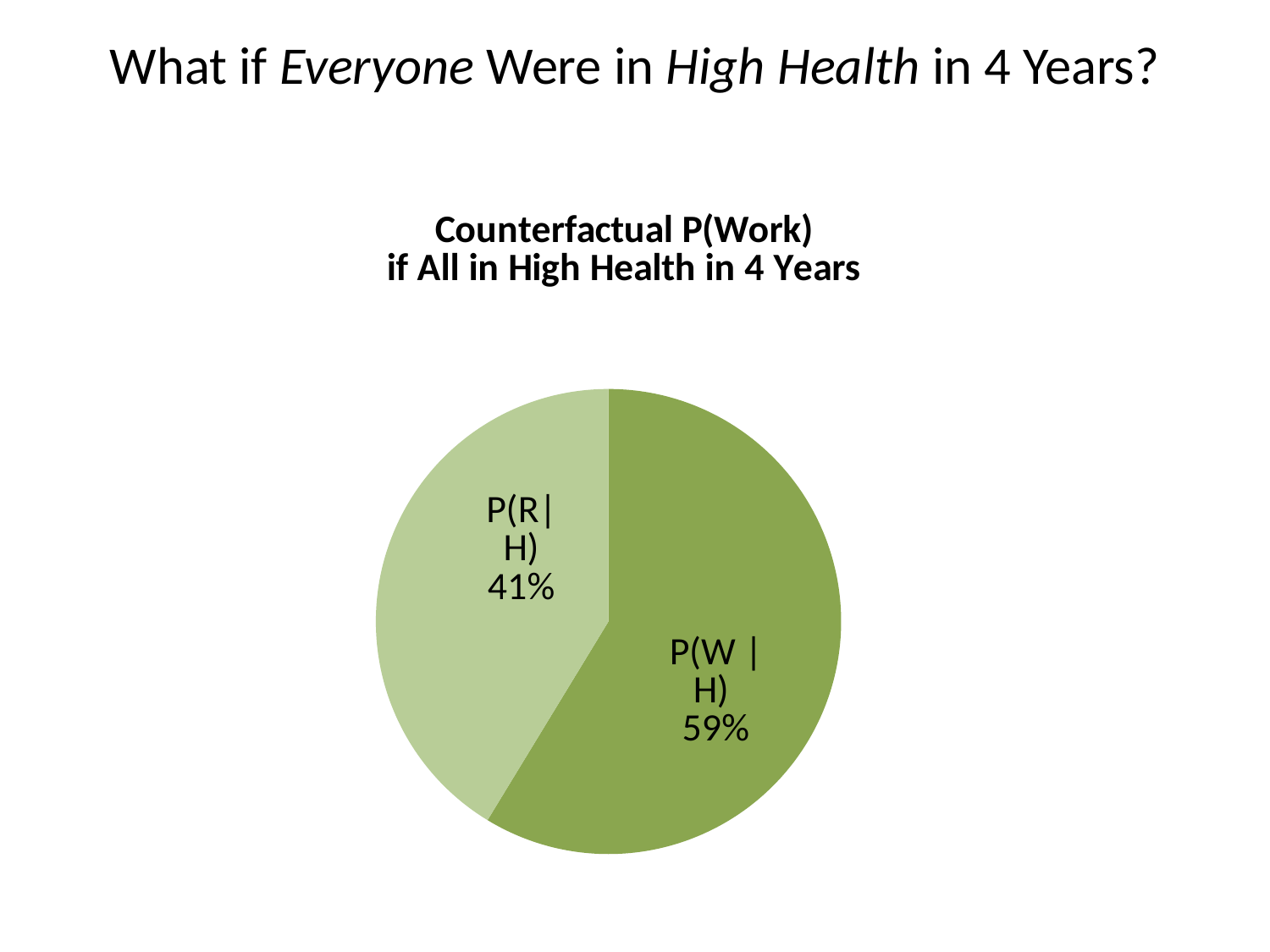
Which is larger, the P(W | H) slice or the P(R | H) slice? P(W | H) What share of the pie is labelled P(R | H)? 41% Which slice of the pie is the largest? P(W | H) What is the difference in percentage points between the P(W | H) slice and the P(R | H) slice? 18 Is the value for P(R | H) greater or less than 50%? less Which slice of the pie is the smallest? P(R | H) What is the title of the chart? Counterfactual P(Work) if All in High Health in 4 Years Is the value for P(W | H) greater or less than 50%? greater How many slices does the pie chart have? 2 What kind of chart is shown on the slide? pie chart What share of the pie is labelled P(W | H)? 59% Which slice is shown in the lighter green colour? P(R | H)